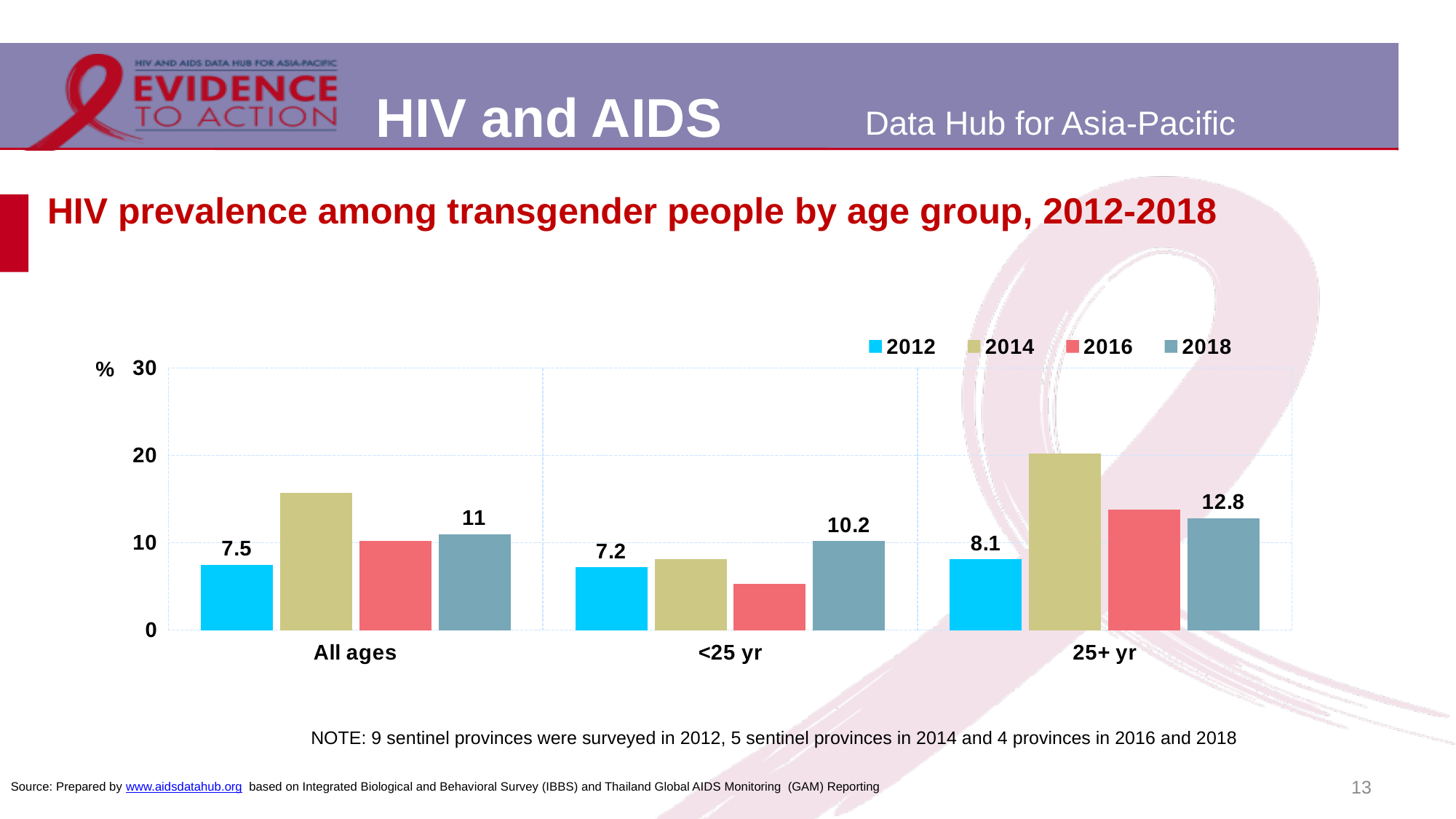
By how much did HIV prevalence in the All ages group increase from 2012 to 2018? 3.5 What is the HIV prevalence for 2018 in the 25+ yr group? 12.8 What is the HIV prevalence for 2018 in the <25 yr group? 10.2 What is the HIV prevalence for 2012 in the <25 yr group? 7.2 Is the 2016 value for the <25 yr group greater or less than 10? less What is the HIV prevalence for 2012 in the All ages group? 7.5 What is the difference between the 2018 and 2012 values for the 25+ yr group? 4.7 Is the 2014 value for the All ages group greater or less than 10? greater Which age group has the highest 2012 value? 25+ yr Which is larger, the 2018 value for All ages or the 2018 value for <25 yr? All ages How many years does the legend list? 4 How many age group categories are shown on the x axis? 3